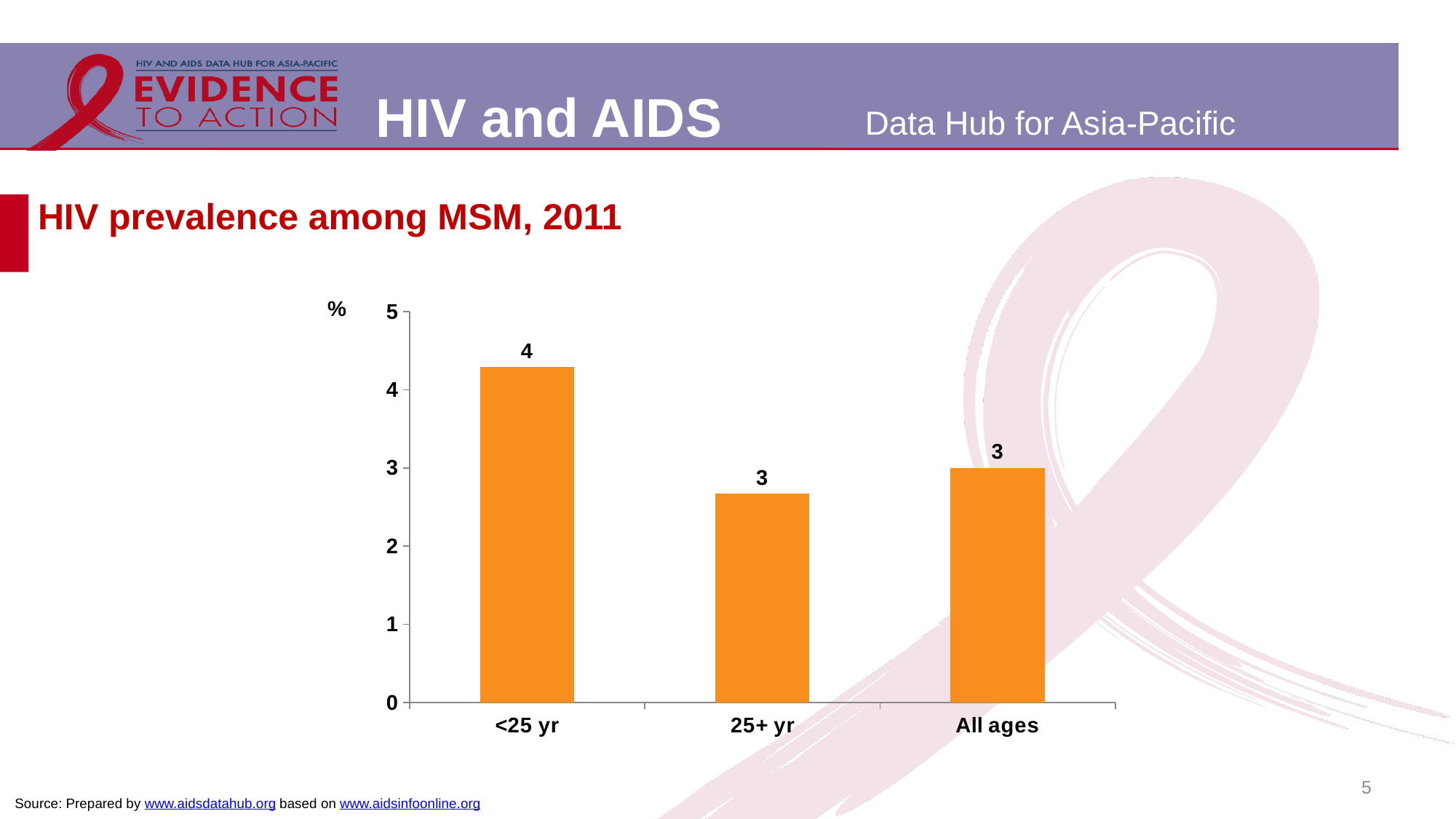
What is the difference between the labelled values for <25 yr and 25+ yr? 1 Which is larger, the value for <25 yr or the value for 25+ yr? <25 yr Is the bar for 25+ yr greater or less than 3 on the axis? less What is the HIV prevalence value shown for All ages? 3 What is the HIV prevalence value shown for the 25+ yr group? 3 What is the title of the chart on this slide? HIV prevalence among MSM, 2011 Which age group has the highest HIV prevalence in the chart? <25 yr What unit is shown at the top of the y axis? % Is the bar for <25 yr greater or less than 4 on the axis? greater How many categories are shown on the x axis of the chart? 3 What kind of chart is used on this slide? bar chart What is the HIV prevalence value shown for the <25 yr group? 4